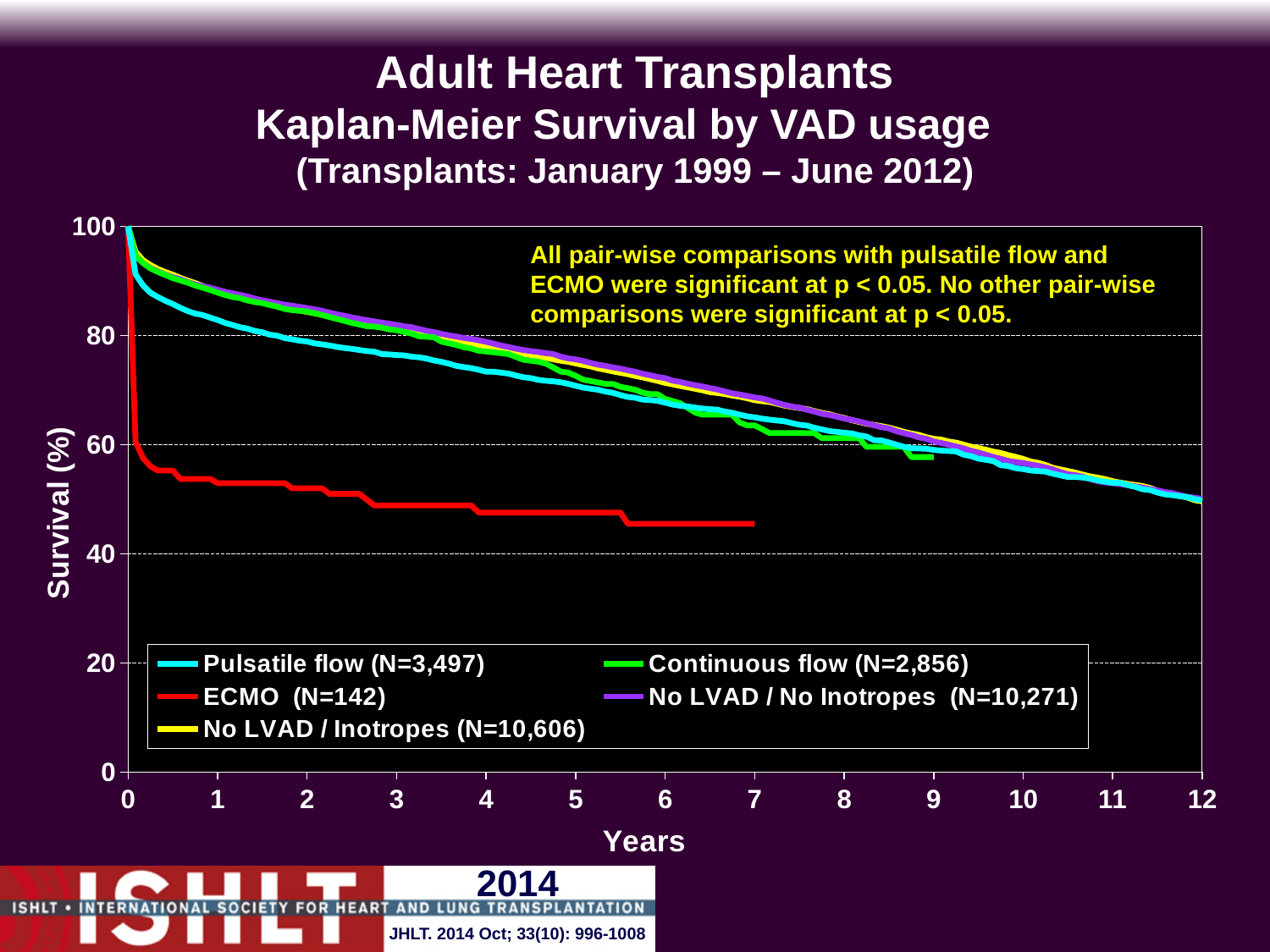
What is the label of the y axis? Survival (%) What kind of chart is shown on the slide? Line chart How many series does the legend list? 5 What is the N for the ECMO group shown in the legend? 142 Is the survival for Pulsatile flow at 6 years greater or less than 80? less At 3 years, which has higher survival: Pulsatile flow or ECMO? Pulsatile flow At 2 years, which has higher survival: Continuous flow or Pulsatile flow? Continuous flow Is the survival for Continuous flow at 2 years greater or less than 80? greater Is the survival for No LVAD / No Inotropes at 10 years greater or less than 40? greater Do the survival curves rise or fall as years increase? Fall Which series has the lowest survival across the chart? ECMO